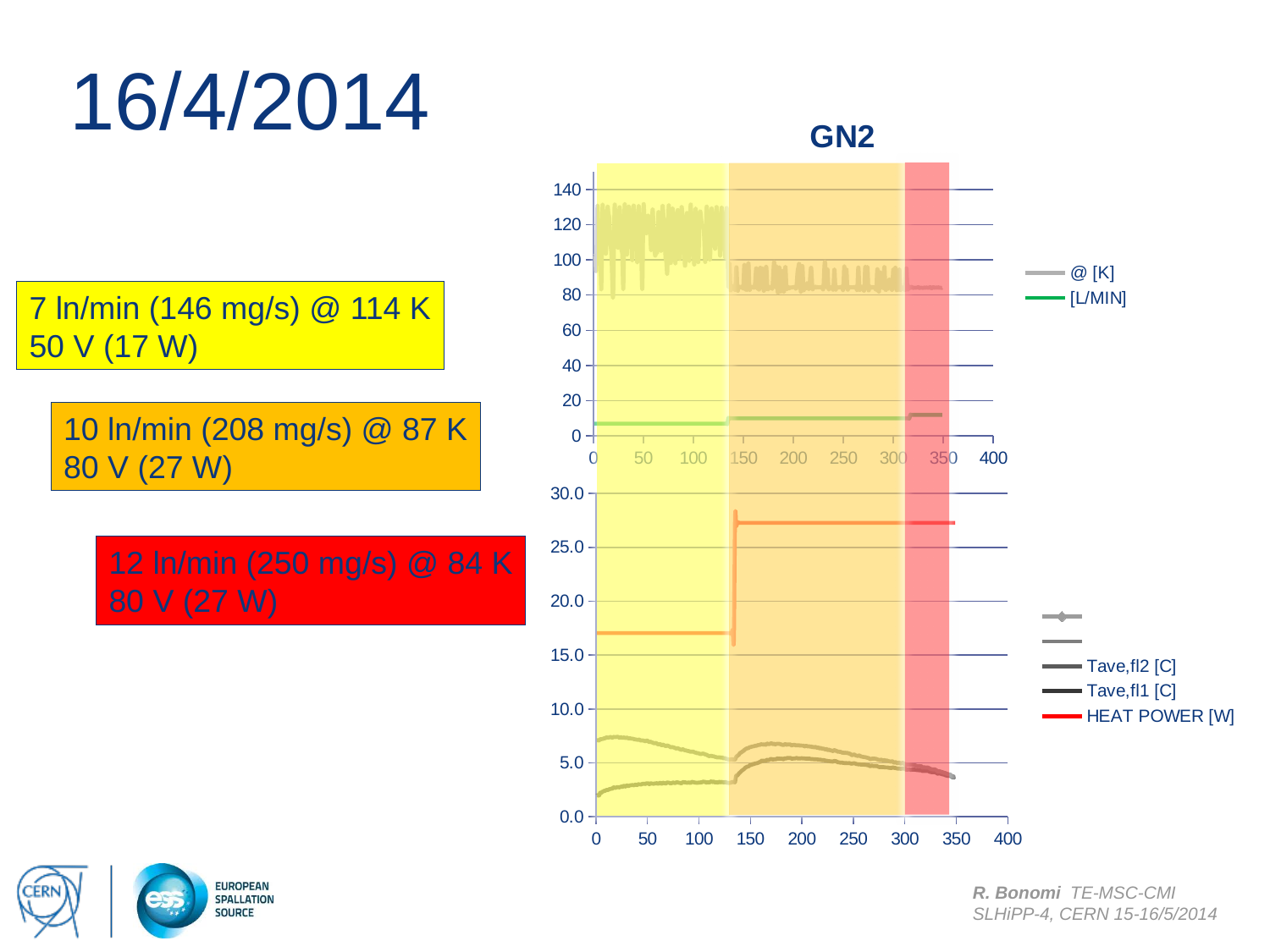
In the top chart titled GN2, is the value of @ [K] at x = 200 greater or less than 100? less In the bottom chart, which is larger at x = 50: Tave,fl2 [C] or Tave,fl1 [C]? Tave,fl2 [C] In the top chart titled GN2, does the [L/MIN] series rise or fall along the x axis? rise In the bottom chart, does the HEAT POWER [W] series rise or fall along the x axis? rise In the top chart titled GN2, is the value of [L/MIN] at x = 50 greater or less than 20? less In the bottom chart, what colour is the HEAT POWER [W] line in the legend? red In the top chart titled GN2, what kind of chart is shown? line chart In the top chart titled GN2, how many series does the legend list? 2 In the top chart titled GN2, does the @ [K] series generally rise or fall along the x axis? fall In the bottom chart, is the HEAT POWER [W] value at x = 200 greater or less than 25? greater What is the title of the top chart? GN2